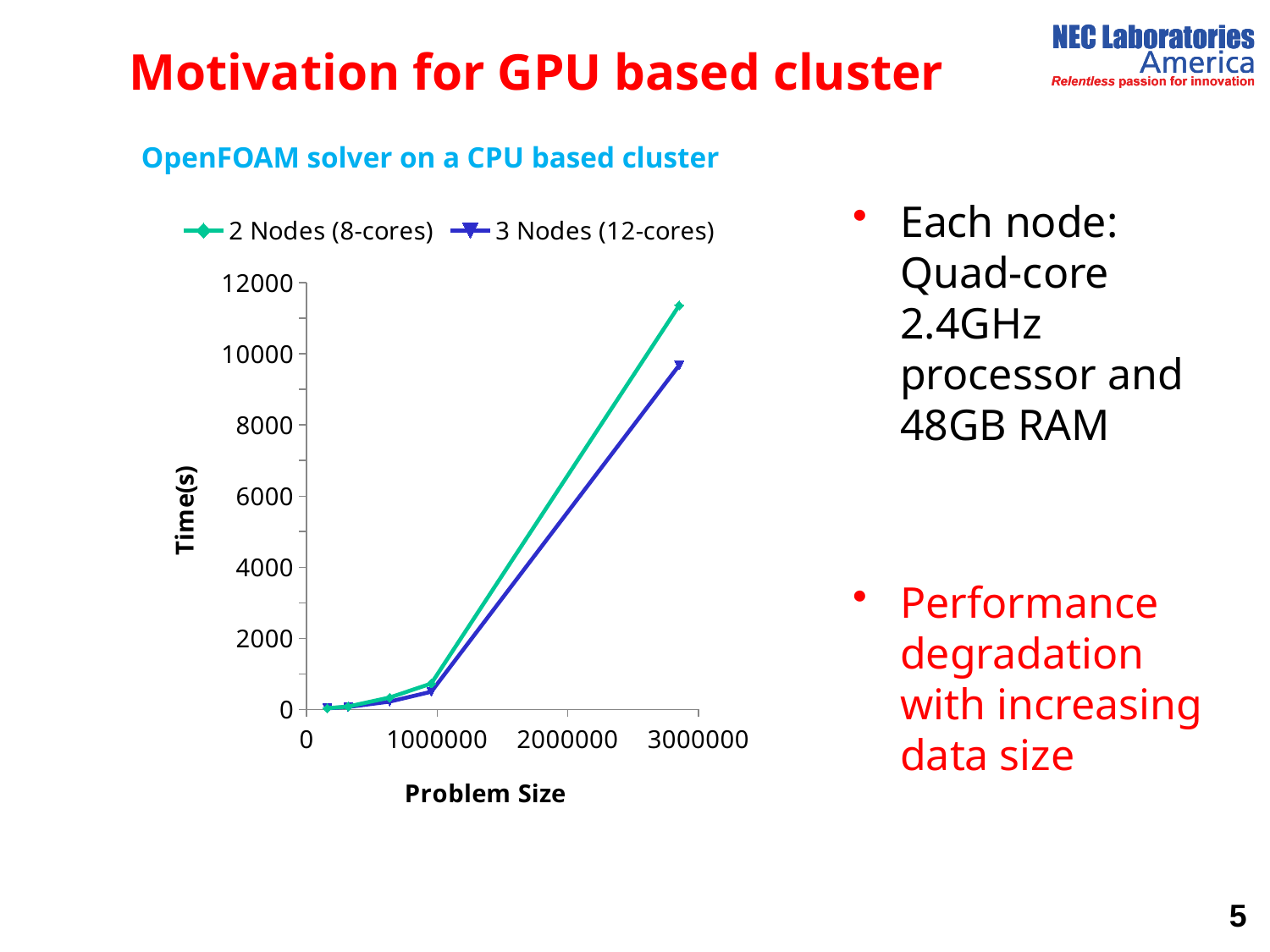
What kind of chart is shown on the slide? line chart Is the time for 3 Nodes (12-cores) at a problem size of about 1000000 greater or less than 2000? less Is the time for 2 Nodes (8-cores) at the largest problem size greater or less than 10000? greater How many series does the chart legend list? 2 Does the time for the 2 Nodes (8-cores) series rise or fall as problem size increases? rise Which series reaches the highest time value on the chart? 2 Nodes (8-cores) What are the two series named in the chart legend? 2 Nodes (8-cores) and 3 Nodes (12-cores) At the largest problem size, which series has the higher time: 2 Nodes (8-cores) or 3 Nodes (12-cores)? 2 Nodes (8-cores) How many data points are plotted for each series? 5 What is the label of the chart's y axis? Time(s) Does the time for the 3 Nodes (12-cores) series rise or fall as problem size increases? rise Is the time for 3 Nodes (12-cores) at the largest problem size greater or less than 10000? less